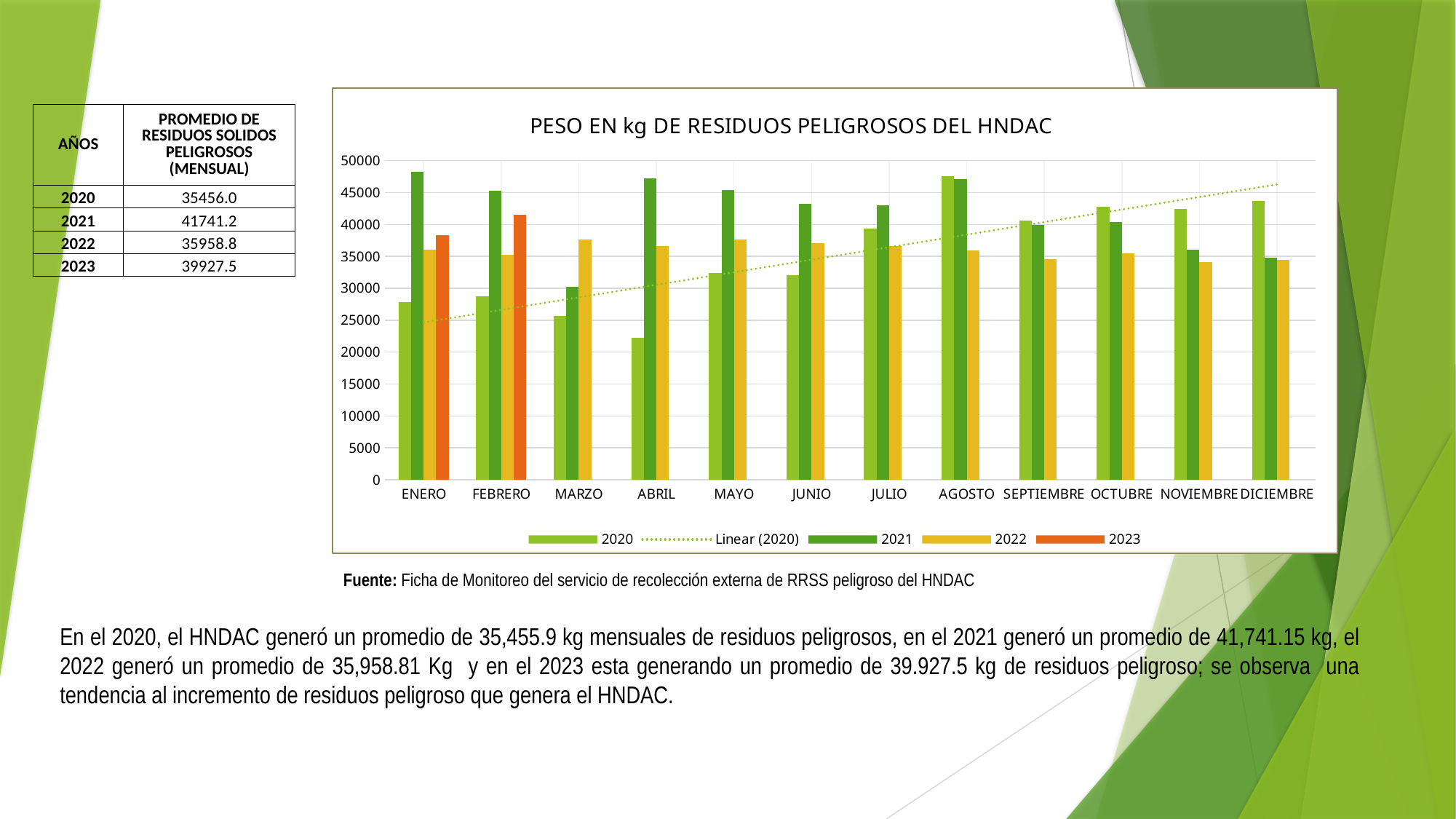
How many entries does the chart's legend list? 5 In which month is the 2021 value lowest? MARZO Does the Linear (2020) trend line rise or fall from ENERO to DICIEMBRE? rises What kind of chart is shown on the slide? bar chart For ENERO, which series has the larger value, 2020 or 2021? 2021 In which month is the 2020 value lowest? ABRIL Is the 2021 value for ENERO greater or less than 45000? greater How many months are shown on the x axis of the chart? 12 What is the title of the chart? PESO EN kg DE RESIDUOS PELIGROSOS DEL HNDAC For DICIEMBRE, which series has the larger value, 2020 or 2021? 2020 Is the 2023 value for FEBRERO greater or less than 40000? greater Is the 2020 value for ABRIL greater or less than 25000? less